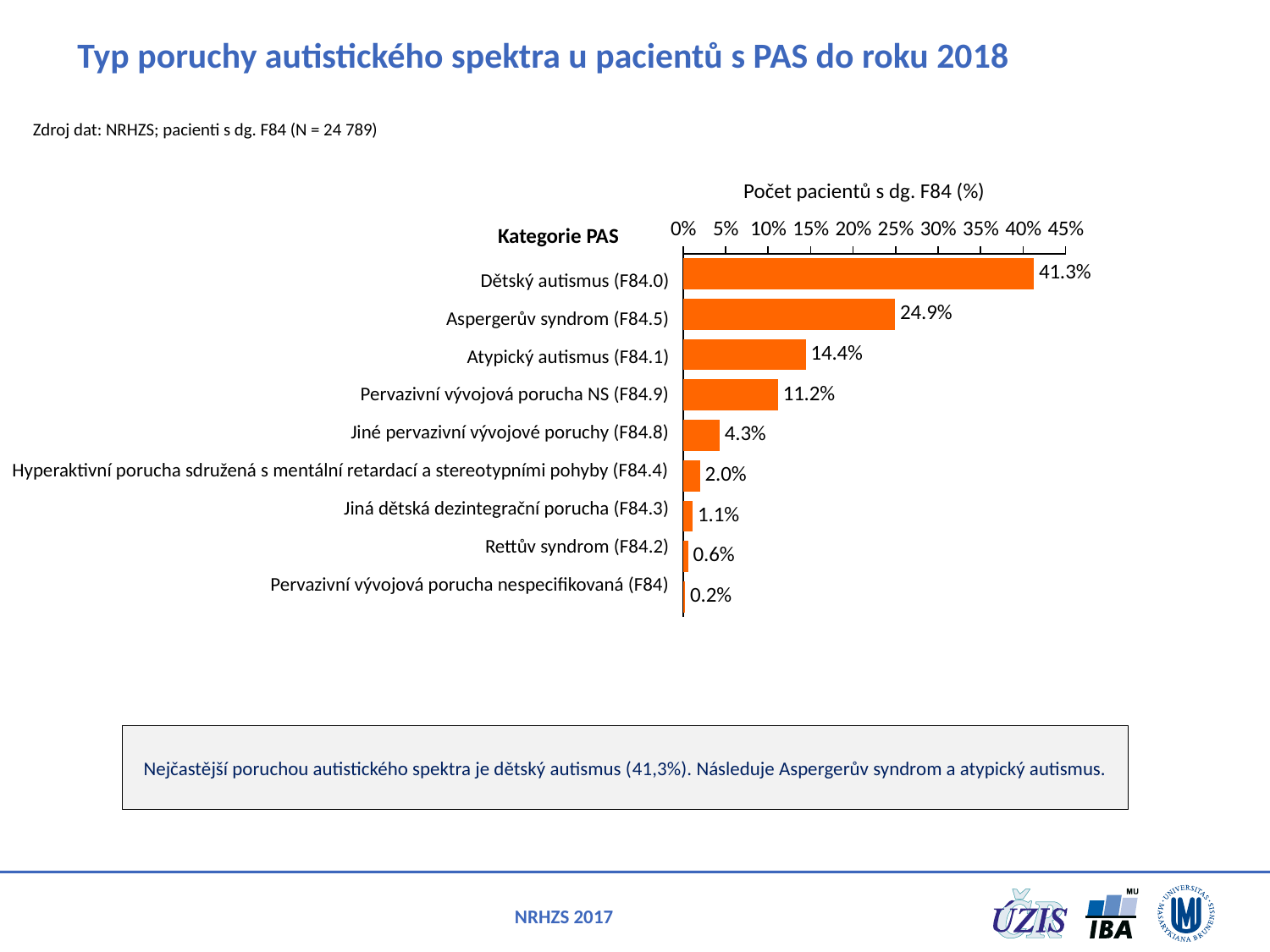
Is the value for Jiné pervazivní vývojové poruchy (F84.8) greater or less than 5%? less What is the value for Aspergerův syndrom (F84.5)? 24.9% What is the value for Dětský autismus (F84.0)? 41.3% What kind of chart is shown on the slide? bar chart What is the value for Pervazivní vývojová porucha NS (F84.9)? 11.2% What is the value for Rettův syndrom (F84.2)? 0.6% Which category has the lowest value? Pervazivní vývojová porucha nespecifikovaná (F84) What is the title of the x axis of the chart? Počet pacientů s dg. F84 (%) Which is larger, the value for Atypický autismus (F84.1) or Pervazivní vývojová porucha NS (F84.9)? Atypický autismus (F84.1) What is the difference between the values for Dětský autismus (F84.0) and Aspergerův syndrom (F84.5)? 16.4% Which category has the highest value? Dětský autismus (F84.0) How many categories are shown in the chart? 9